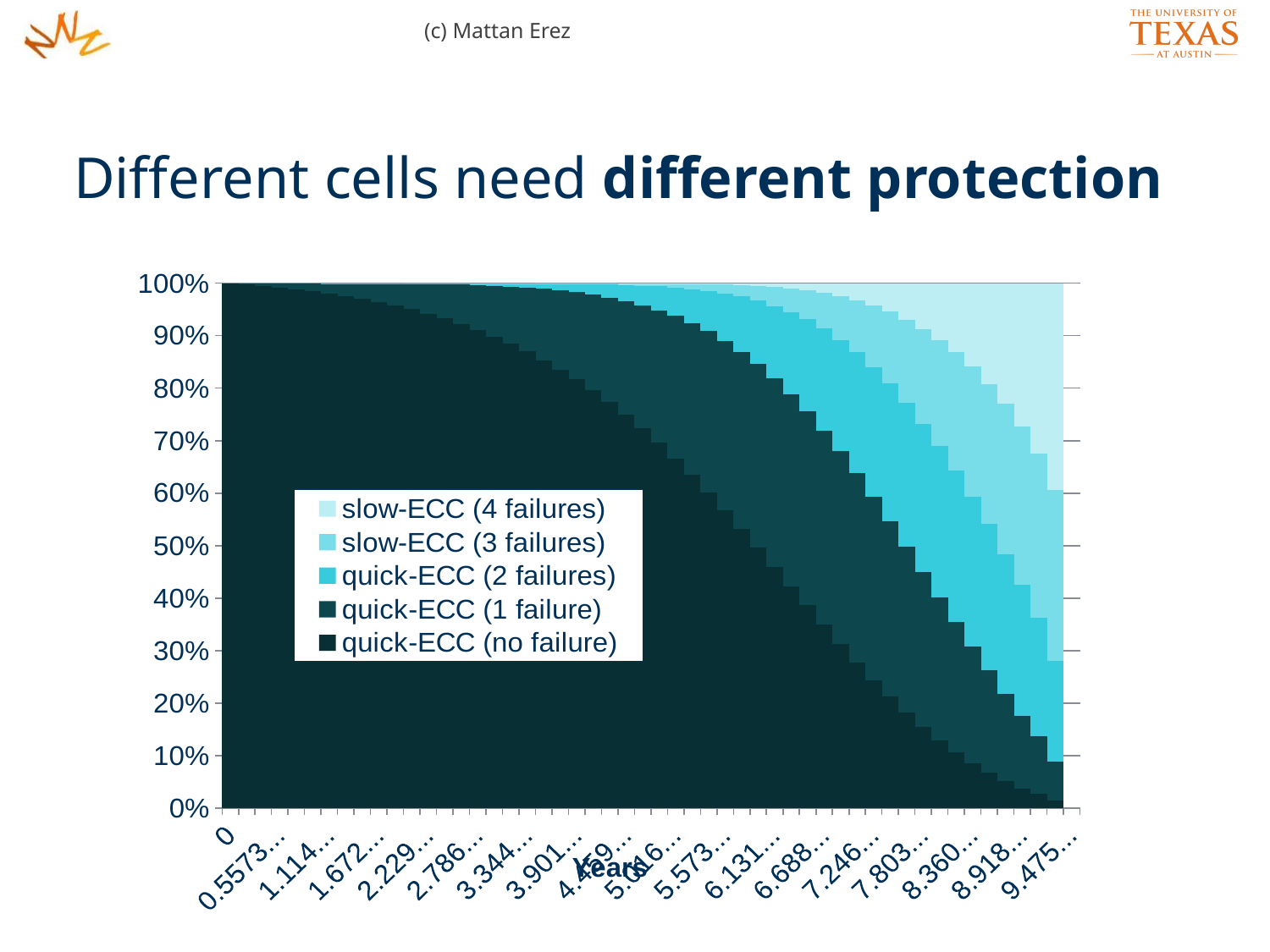
What do the stacked segments sum to at each year on the chart? 100% How many series does the legend list? 5 Does the share of quick-ECC (no failure) rise or fall as the years increase? fall Which series is listed first in the legend? slow-ECC (4 failures) At year 0, is the share of quick-ECC (no failure) greater or less than 90%? greater Which series has the largest share at year 0? quick-ECC (no failure) At the rightmost year (9.475...), which series has the larger share: slow-ECC (4 failures) or quick-ECC (no failure)? slow-ECC (4 failures) At the rightmost year (9.475...), is the share of quick-ECC (no failure) greater or less than 20%? less What kind of chart is shown on the slide? stacked bar chart Does the share of slow-ECC (4 failures) rise or fall as the years increase? rise At year 0, which series has the larger share: quick-ECC (no failure) or slow-ECC (4 failures)? quick-ECC (no failure) What is the title of the x axis? Years